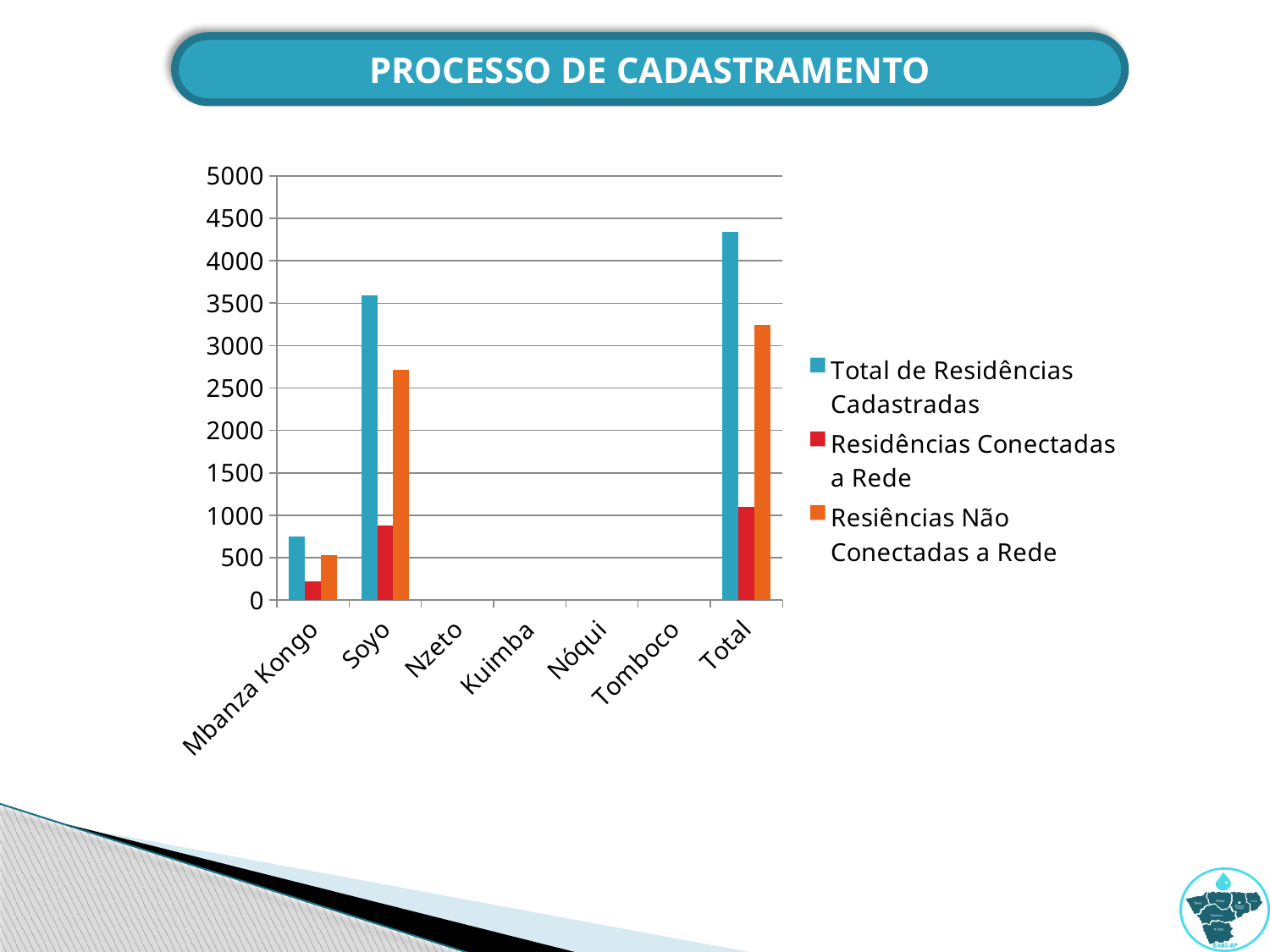
Which is larger for Total de Residências Cadastradas: Soyo or Mbanza Kongo? Soyo What kind of chart is shown on the slide? bar chart Excluding the Total category, which municipality has the highest value for Total de Residências Cadastradas? Soyo Which category has the highest value for Total de Residências Cadastradas? Total How many categories are shown on the x axis? 7 What is the title shown above the chart? PROCESSO DE CADASTRAMENTO Is the value for Total de Residências Cadastradas in the Total category greater or less than 4000? greater Is the value for Total de Residências Cadastradas in Mbanza Kongo greater or less than 1000? less How many series does the legend list? 3 Is the value for Total de Residências Cadastradas in Soyo greater or less than 3000? greater